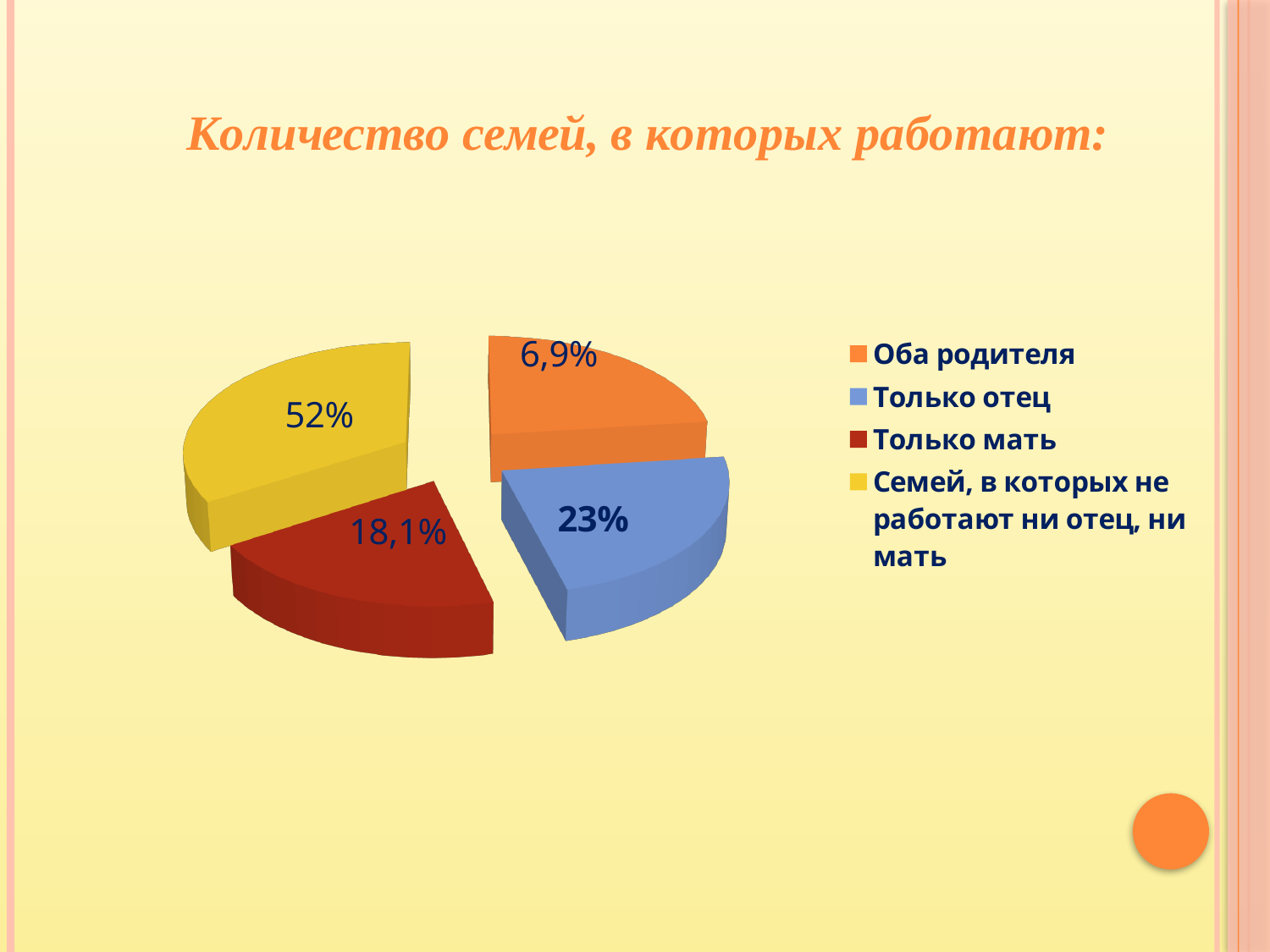
What type of chart is shown on the slide? Pie chart How many slices does the pie chart have? 4 What is the title of the chart on the slide? Количество семей, в которых работают: Which category has the largest share of the pie? Семей, в которых не работают ни отец, ни мать What percentage is shown for 'Семей, в которых не работают ни отец, ни мать'? 52% What percentage is shown for 'Только отец'? 23% What colour is the slice for 'Только мать'? Red Which category has the smallest labelled share of the pie? Оба родителя What percentage is shown for 'Оба родителя'? 6,9% What percentage is shown for 'Только мать'? 18,1% Which is larger: the share for 'Только отец' or for 'Только мать'? Только отец How many series does the legend list? 4